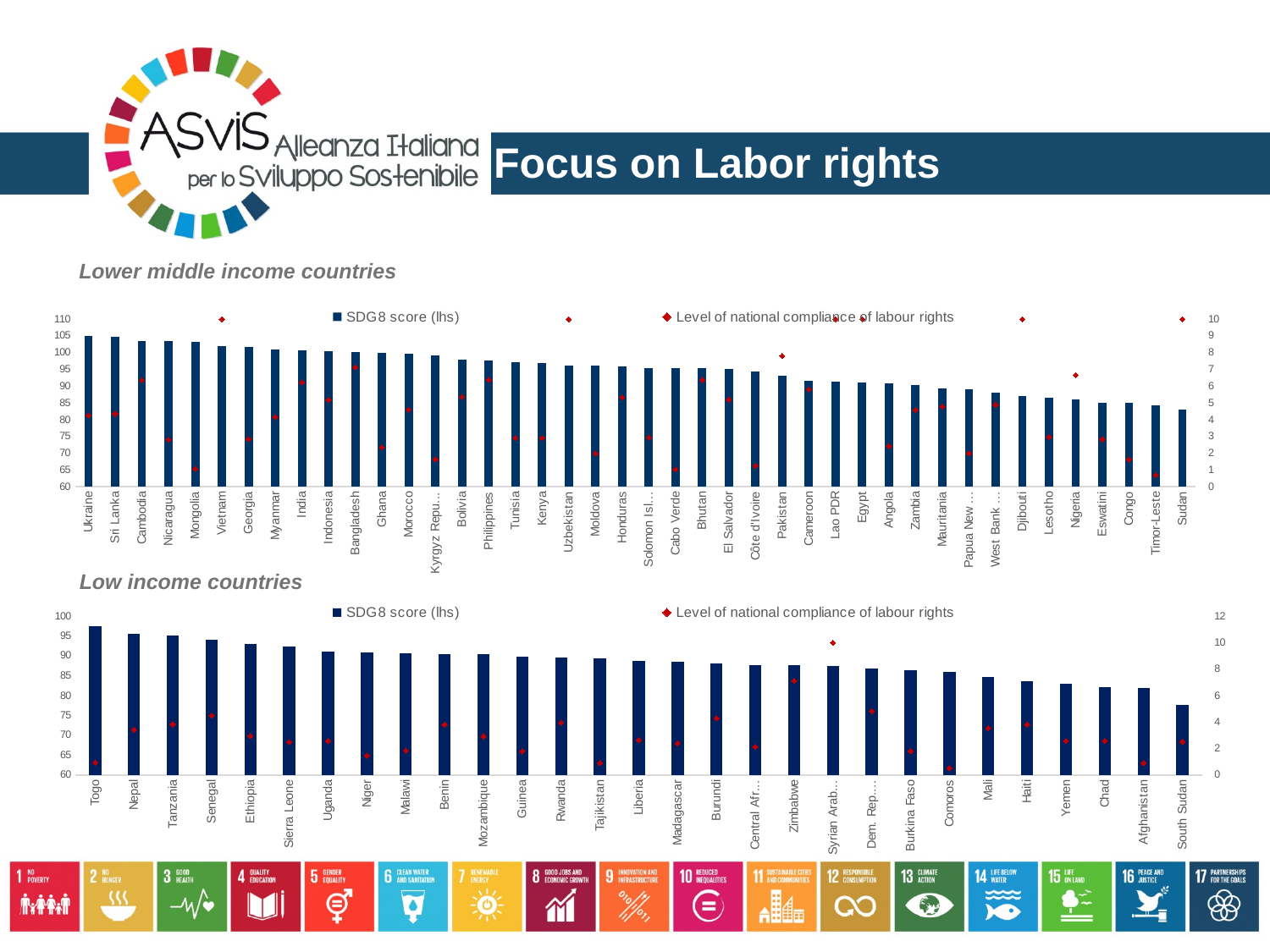
In the 'Lower middle income countries' chart, is the level of national compliance of labour rights for Vietnam greater or less than 8? greater In the 'Lower middle income countries' chart, how many series does the legend list? 2 In the 'Lower middle income countries' chart, which has the higher SDG8 score, Ukraine or Sudan? Ukraine In the 'Lower middle income countries' chart, do the SDG8 score bars rise or fall from left to right? fall In the 'Low income countries' chart, what are the two series named in the legend? SDG8 score (lhs) and Level of national compliance of labour rights In the 'Low income countries' chart, how many countries are shown on the x axis? 29 In the 'Low income countries' chart, which country has the highest SDG8 score? Togo In the 'Low income countries' chart, is the level of national compliance of labour rights for Togo greater or less than 2? less In the 'Lower middle income countries' chart, is the SDG8 score for Sudan greater or less than 85? less In the 'Low income countries' chart, which country has the lowest SDG8 score? South Sudan